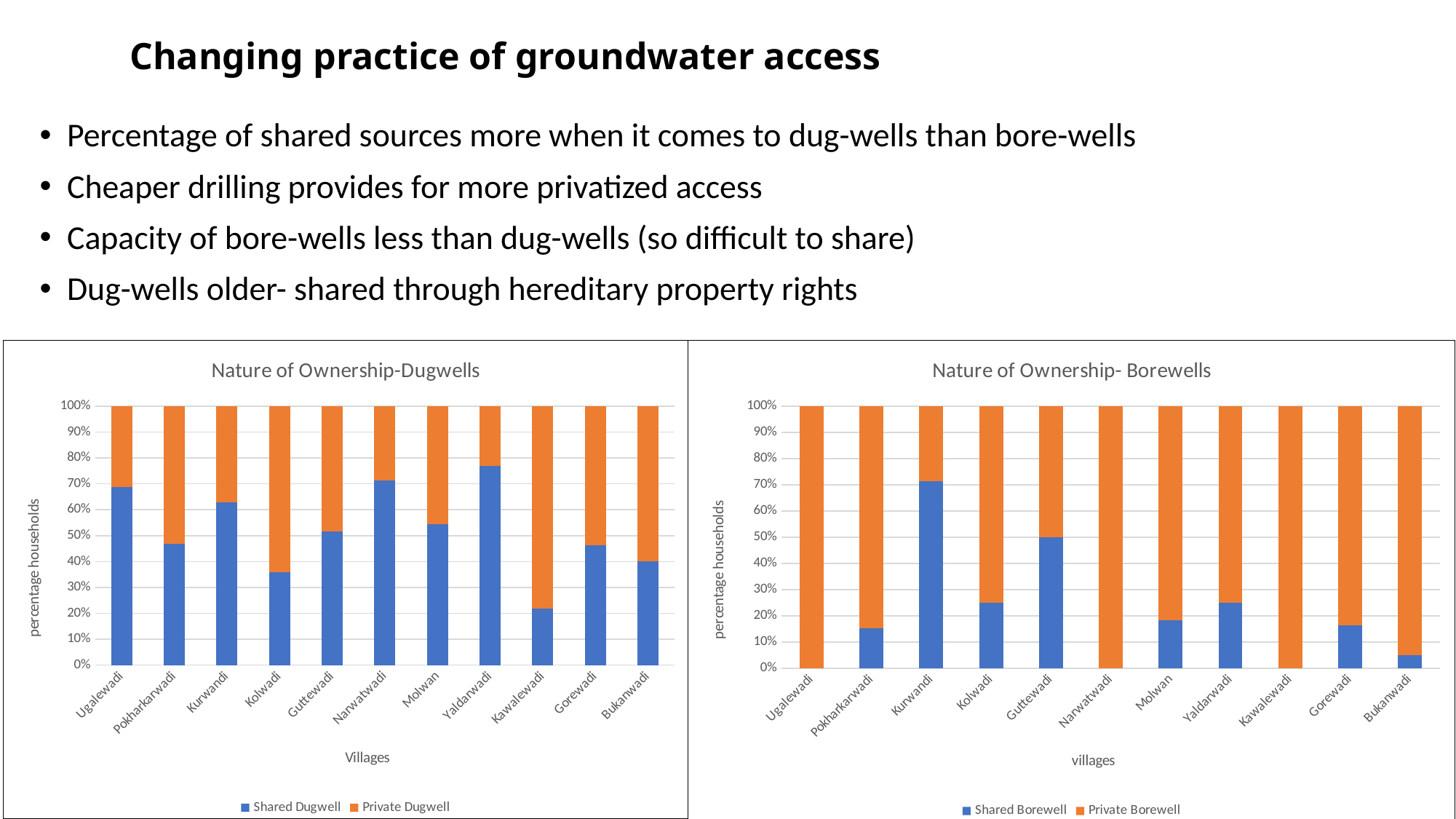
How many villages are shown on the x axis of the 'Nature of Ownership-Dugwells' chart? 11 In the 'Nature of Ownership-Dugwells' chart, which village has a larger Shared Dugwell share, Kurwandi or Kolwadi? Kurwandi What are the two legend entries of the 'Nature of Ownership- Borewells' chart? Shared Borewell and Private Borewell In the 'Nature of Ownership- Borewells' chart, which village has a larger Shared Borewell share, Guttewadi or Pokharkarwadi? Guttewadi In the 'Nature of Ownership-Dugwells' chart, is the Shared Dugwell value for Kolwadi greater or less than 40%? less In the 'Nature of Ownership-Dugwells' chart, is the Shared Dugwell value for Ugalewadi greater or less than 60%? greater What kind of chart is the 'Nature of Ownership-Dugwells' chart? Stacked bar chart In the 'Nature of Ownership-Dugwells' chart, which village has the lowest share of Shared Dugwell? Kawalewadi In the 'Nature of Ownership- Borewells' chart, what is the total height of the stacked bar for Kurwandi? 100% In the 'Nature of Ownership- Borewells' chart, which village has the highest share of Shared Borewell? Kurwandi In the 'Nature of Ownership-Dugwells' chart, which village has the highest share of Shared Dugwell? Yaldarwadi How many series does the legend of the 'Nature of Ownership- Borewells' chart list? 2